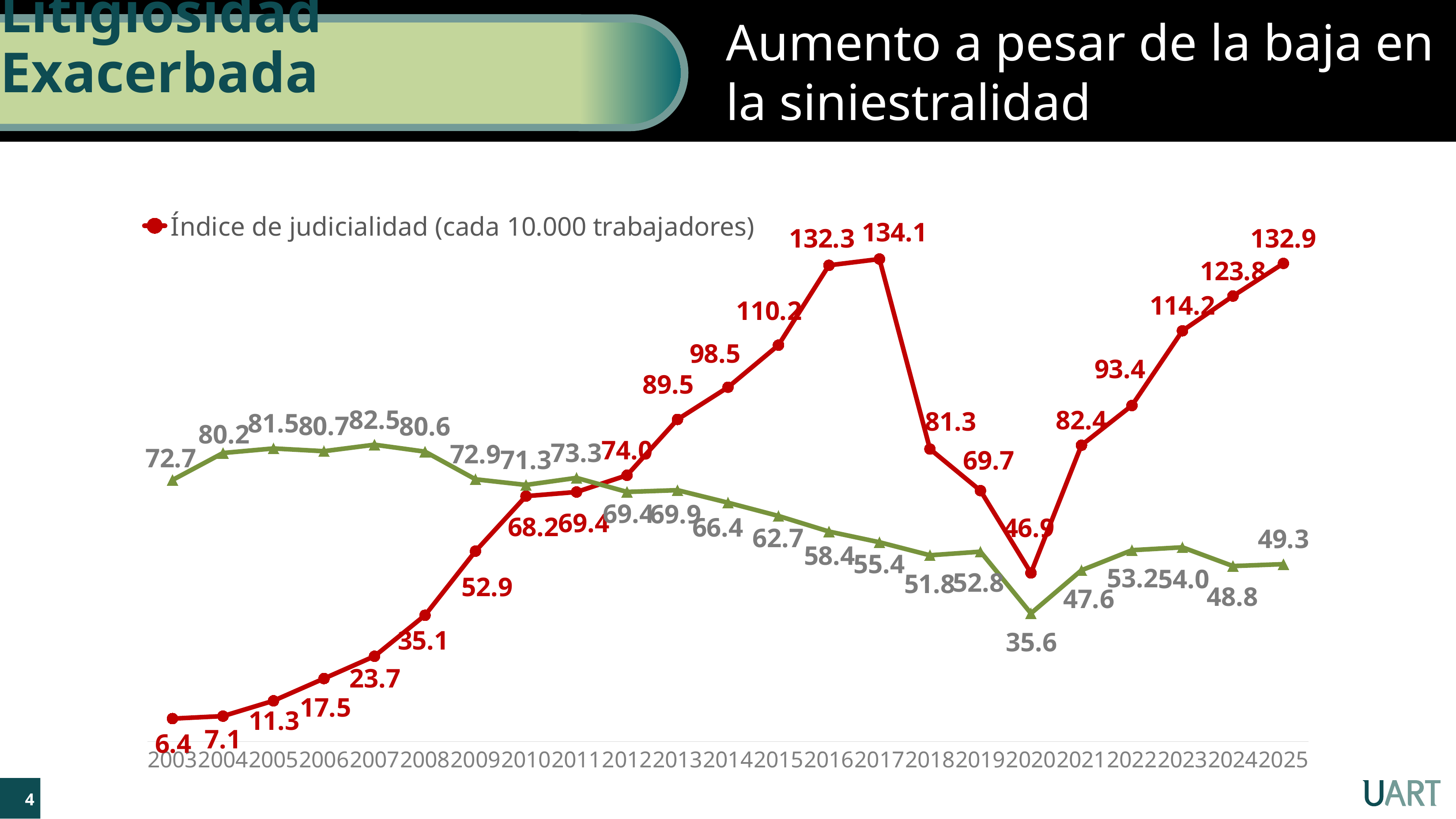
What is the difference between the Índice de judicialidad values for 2025 and 2024? 9.1 In 2010, which is larger: the Índice de judicialidad (68.2) or the green line (71.3)? The green line How many years are shown on the x axis of the chart? 23 What is the value of the Índice de judicialidad (cada 10.000 trabajadores) in 2017? 134.1 How many series does the chart's legend list? 1 What kind of chart is shown on the slide? Line chart Does the green line rise or fall overall from 2003 to 2025? Fall In which year does the Índice de judicialidad (cada 10.000 trabajadores) reach its highest value? 2017 What is the value of the Índice de judicialidad (cada 10.000 trabajadores) in 2003? 6.4 What is the value of the green line in 2020? 35.6 What is the value of the green line in 2007? 82.5 In which year is the Índice de judicialidad (cada 10.000 trabajadores) lowest? 2003